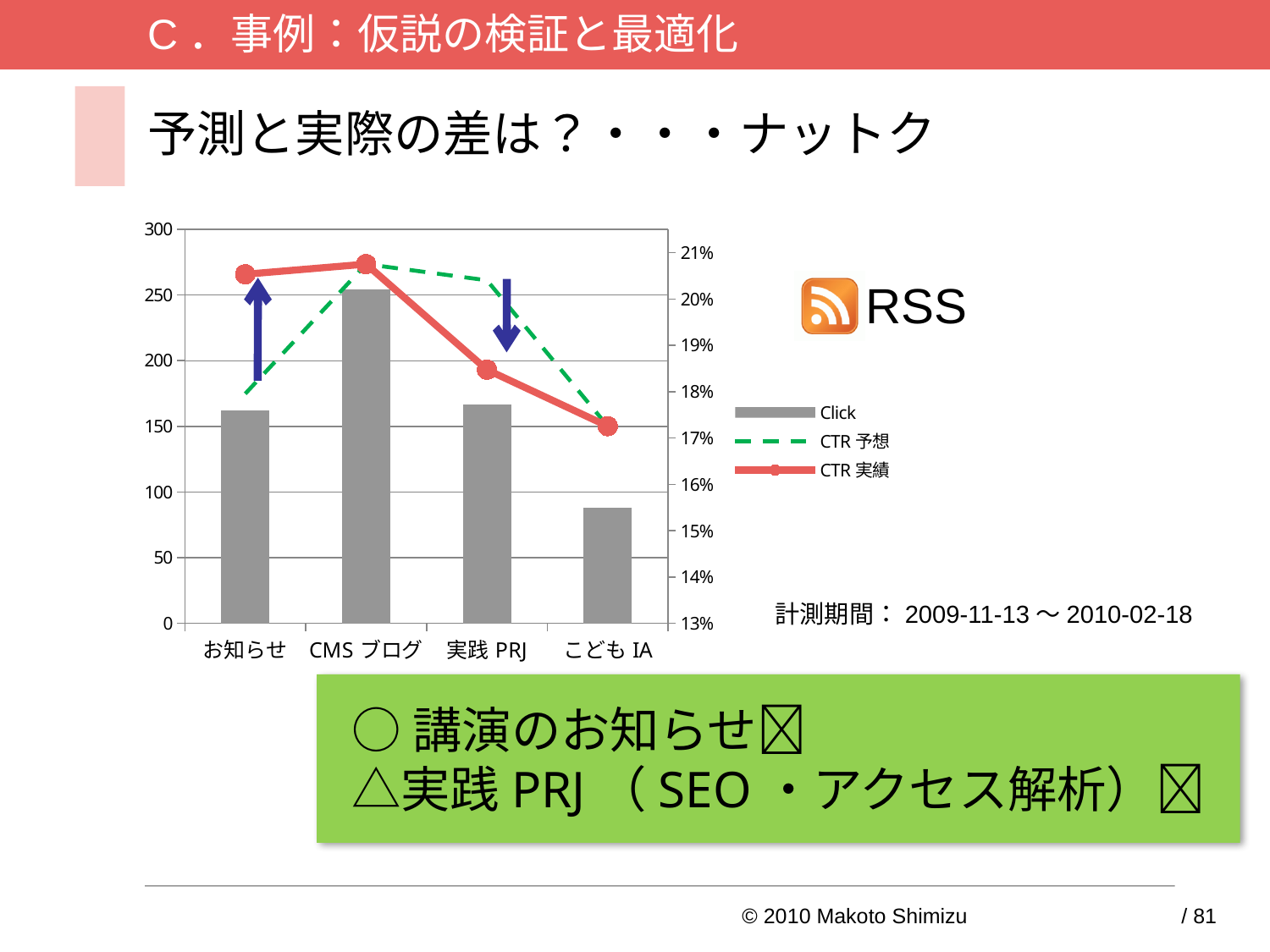
Which category has the lowest CTR 実績 value? こども IA Does the CTR 実績 line rise or fall from CMS ブログ to こども IA? fall For お知らせ, which is higher: CTR 予想 or CTR 実績? CTR 実績 Which category has the lowest Click bar? こども IA Which series in the legend is drawn as a dashed green line? CTR 予想 What kind of chart is shown on the slide? Combined bar and line chart Which category has the highest Click bar? CMS ブログ Is the Click value for こども IA greater or less than 100? less How many categories are shown on the x axis of the chart? 4 Is the Click value for CMS ブログ greater or less than 200? greater For 実践 PRJ, which is higher: CTR 予想 or CTR 実績? CTR 予想 How many series does the chart legend list? 3